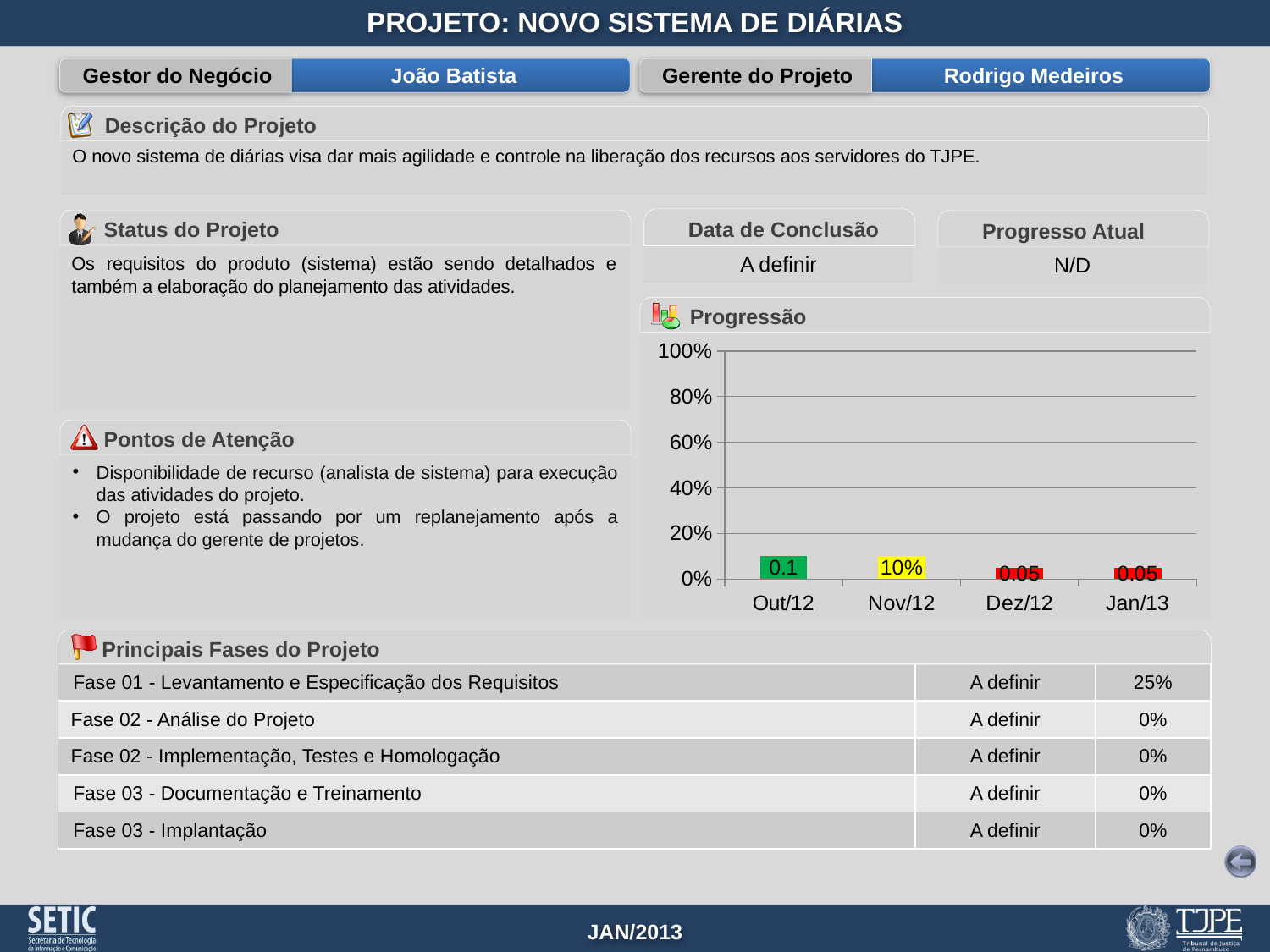
What is the data label shown for Nov/12 in the Progressão chart? 10% What kind of chart is the Progressão chart? bar chart What colour is the bar for Out/12 in the Progressão chart? green In the Progressão chart, which is larger, the value for Out/12 or the value for Dez/12? Out/12 Is the value for Nov/12 in the Progressão chart greater or less than 20%? less In the Progressão chart, which is larger, the value for Nov/12 or the value for Jan/13? Nov/12 What is the title of the chart on the slide? Progressão How many categories are shown on the x axis of the Progressão chart? 4 What is the data label shown for Out/12 in the Progressão chart? 0.1 Do the values in the Progressão chart rise or fall from Out/12 to Jan/13? fall What is the data label shown for Jan/13 in the Progressão chart? 0.05 What is the data label shown for Dez/12 in the Progressão chart? 0.05